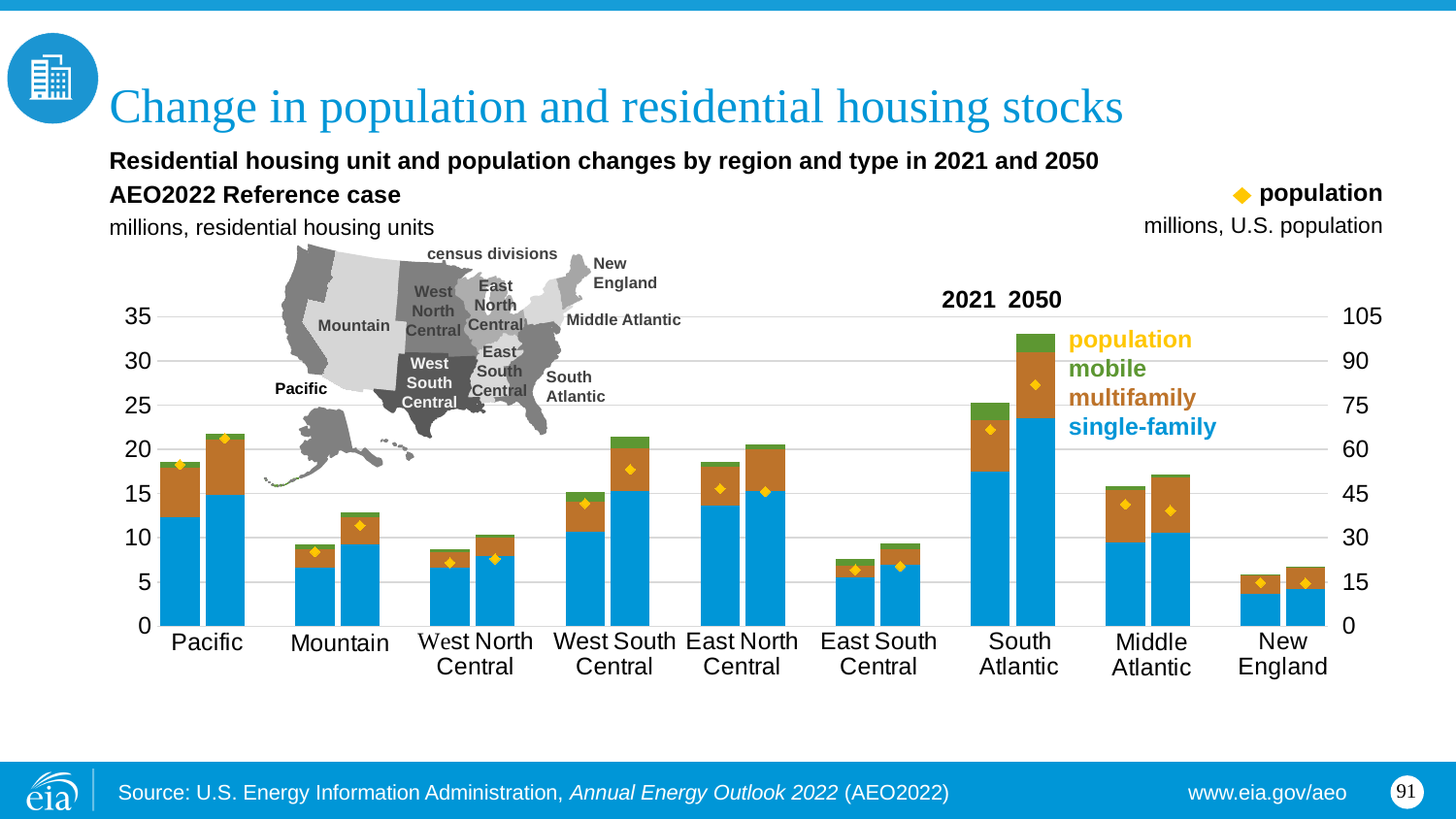
Is the total residential housing units for Pacific in 2021 greater or less than 15 million? greater How many entries does the chart legend list? 4 Which has the larger total residential housing units in 2050, Pacific or Mountain? Pacific Which housing type is shown in blue at the bottom of each stacked bar? single-family Which has the larger total residential housing units in 2050, South Atlantic or Pacific? South Atlantic Which region has the tallest stacked bar for 2050? South Atlantic Is the total residential housing units for New England in 2050 greater or less than 10 million? less Is the total residential housing units for Mountain in 2021 greater or less than 10 million? less How many census regions are shown on the x axis of the chart? 9 Which region has the shortest stacked bar for 2021? New England What kind of chart is used to show residential housing units by region? bar chart